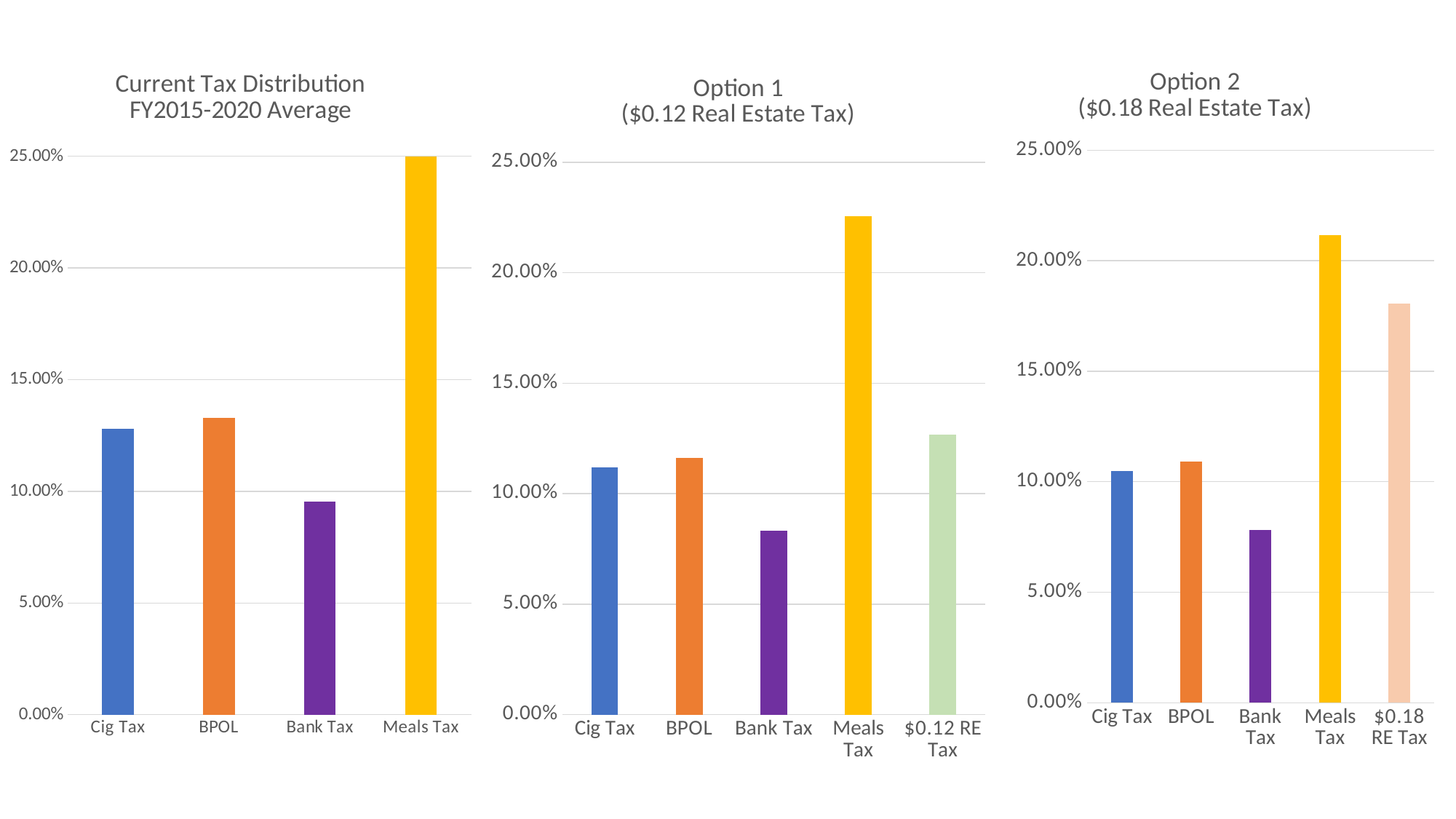
How many categories are shown in the 'Option 2 ($0.18 Real Estate Tax)' chart? 5 How many categories are shown in the 'Current Tax Distribution FY2015-2020 Average' chart? 4 What kind of chart is the 'Option 1 ($0.12 Real Estate Tax)' chart? bar chart In the 'Option 1 ($0.12 Real Estate Tax)' chart, which is larger, the value for $0.12 RE Tax or the value for BPOL? $0.12 RE Tax In the 'Option 1 ($0.12 Real Estate Tax)' chart, which category has the highest value? Meals Tax In the 'Option 2 ($0.18 Real Estate Tax)' chart, which category has the lowest value? Bank Tax In the 'Option 2 ($0.18 Real Estate Tax)' chart, which is larger, the value for Meals Tax or the value for $0.18 RE Tax? Meals Tax In the 'Option 2 ($0.18 Real Estate Tax)' chart, is the value for $0.18 RE Tax greater or less than 15.00%? greater In the 'Current Tax Distribution FY2015-2020 Average' chart, is the value for Bank Tax greater or less than 10.00%? less In the 'Current Tax Distribution FY2015-2020 Average' chart, which category has the lowest value? Bank Tax In the 'Option 1 ($0.12 Real Estate Tax)' chart, is the value for Meals Tax greater or less than 20.00%? greater In the 'Current Tax Distribution FY2015-2020 Average' chart, which category has the highest value? Meals Tax